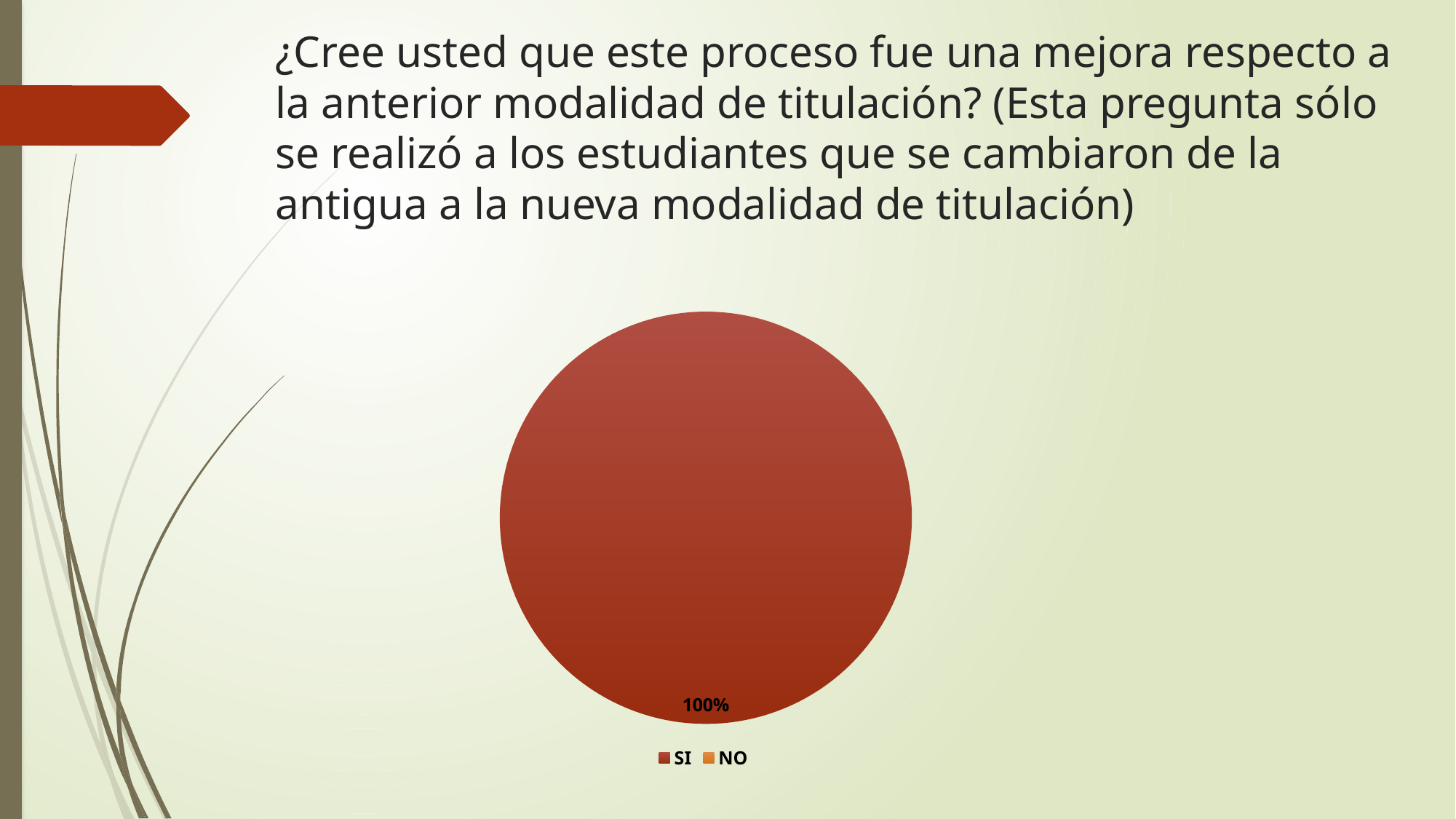
What kind of chart is shown on the slide? pie chart How many entries does the legend list? 2 Which is larger, the share for SI or the share for NO? SI Which category has the largest share of the pie? SI Which category has the smallest share of the pie? NO Is the share for SI greater or less than 50%? greater What share of the pie does SI represent? 100% What is the only data label printed on the pie? 100% What colour is the NO entry in the legend? orange What colour is the SI slice in the legend? red